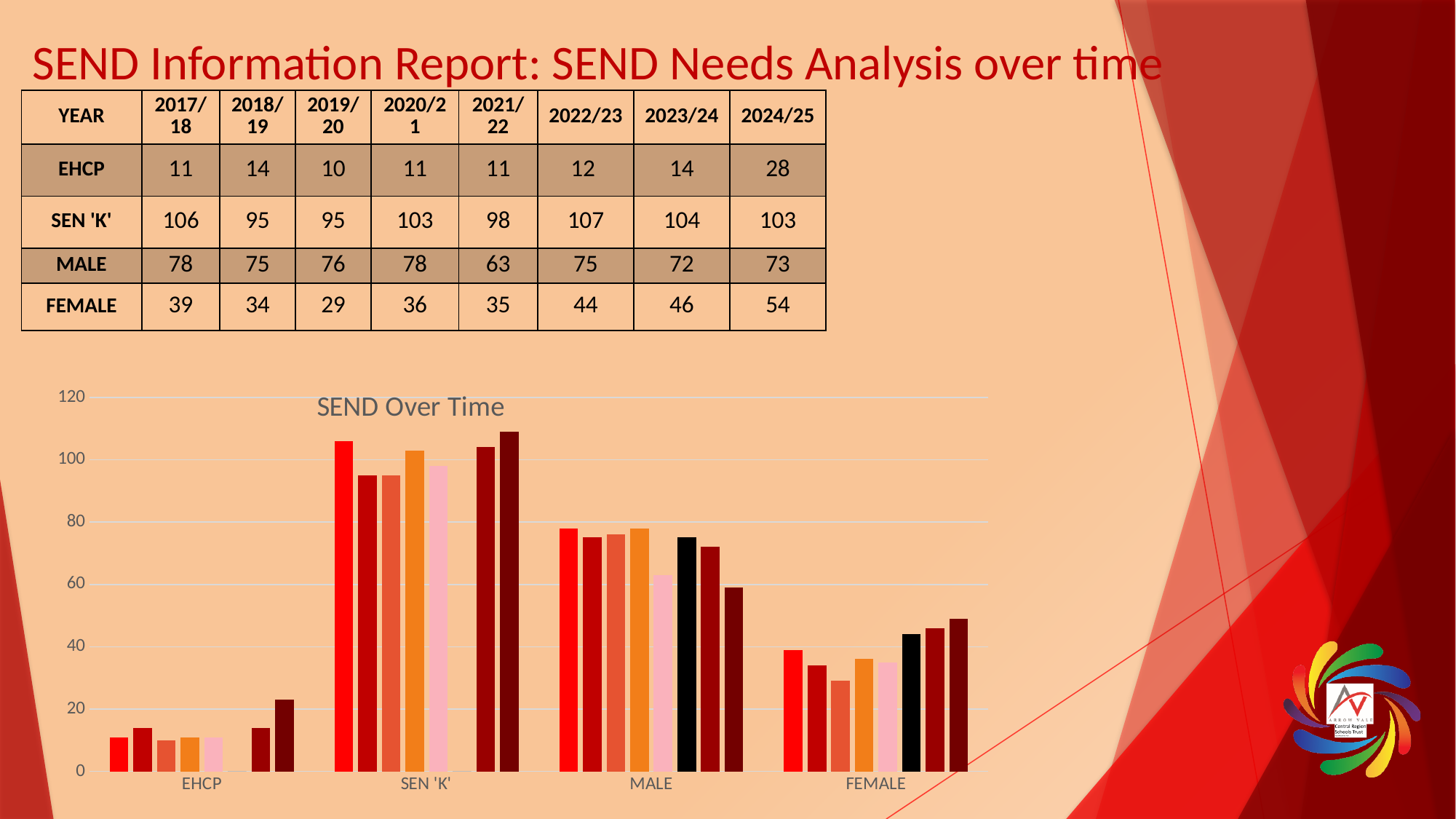
On the 'SEND Over Time' chart, is the tallest bar in the EHCP group greater or less than 40? less What is the title of the chart on the slide? SEND Over Time Which category on the 'SEND Over Time' chart has the shortest bars? EHCP What kind of chart is the 'SEND Over Time' chart? bar chart What is the highest value shown on the y axis of the 'SEND Over Time' chart? 120 On the 'SEND Over Time' chart, which category has taller bars, FEMALE or EHCP? FEMALE On the 'SEND Over Time' chart, is the first (red) bar in the SEN 'K' group greater or less than 100? greater On the 'SEND Over Time' chart, which category has taller bars, SEN 'K' or MALE? SEN 'K' Which category on the 'SEND Over Time' chart has the tallest bars? SEN 'K' On the 'SEND Over Time' chart, is the tallest bar in the FEMALE group greater or less than 60? less How many categories are shown on the x axis of the 'SEND Over Time' chart? 4